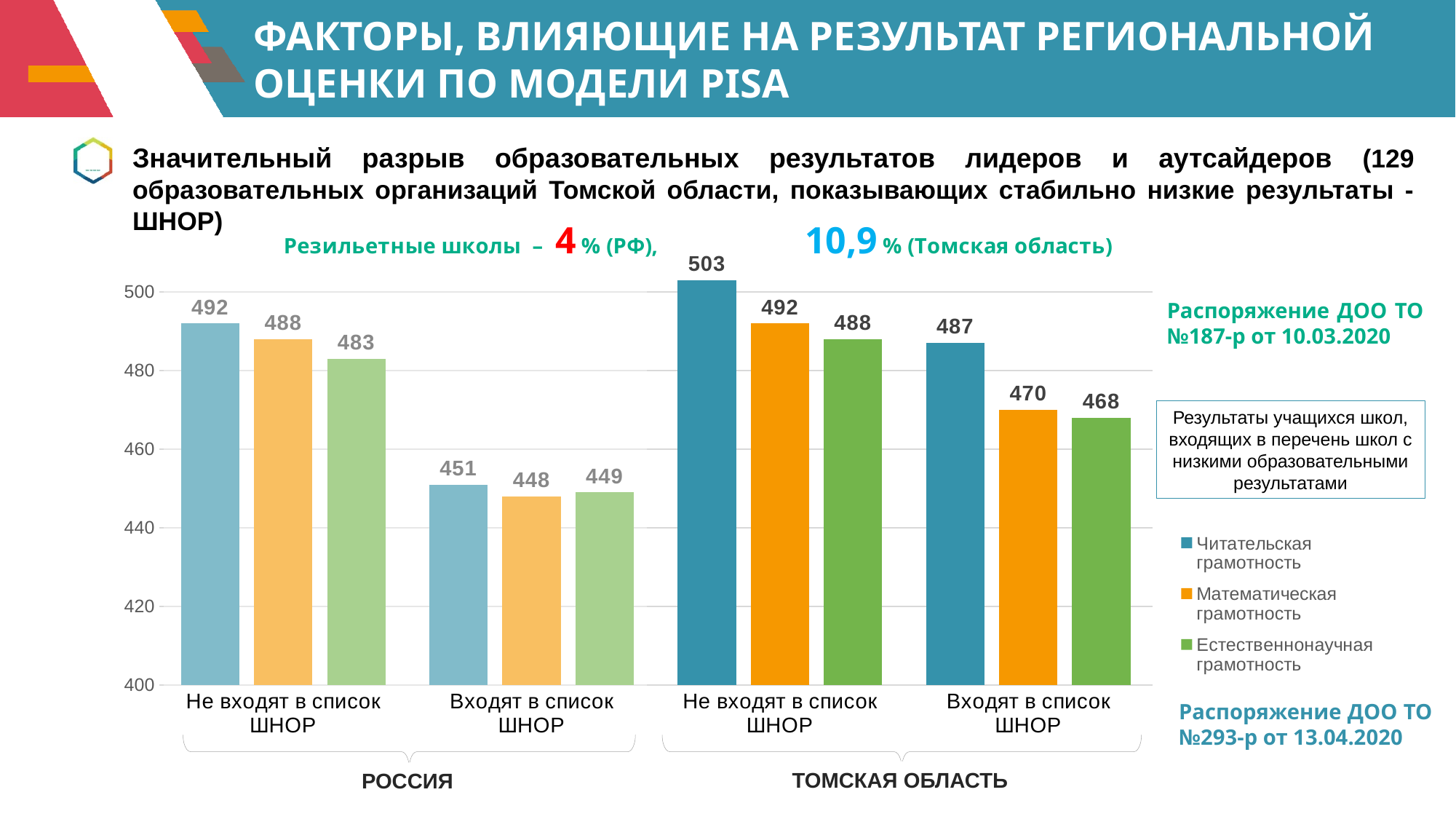
Which colour represents Математическая грамотность in the legend? Orange How many category groups are shown on the x axis? 4 What is the value of Естественнонаучная грамотность for schools in Томская область that are in the ШНОР list (Входят в список ШНОР)? 468 Which is larger: Читательская грамотность for Томская область schools in the ШНОР list, or Читательская грамотность for Россия schools not in the ШНОР list? Россия, Не входят в список ШНОР (492) What kind of chart is shown on the slide? Bar chart Which bar has the highest value on the chart? Читательская грамотность, Томская область, Не входят в список ШНОР (503) What is the difference between Математическая грамотность for Томская область schools not in the ШНОР list and those in the ШНОР list? 22 What is the value of Математическая грамотность for schools in Россия that are in the ШНОР list (Входят в список ШНОР)? 448 Which bar has the lowest value on the chart? Математическая грамотность, Россия, Входят в список ШНОР (448) How many series does the legend list? 3 What is the difference between Читательская грамотность for Россия schools not in the ШНОР list and Россия schools in the ШНОР list? 41 What is the value of Читательская грамотность for schools in Томская область that are not in the ШНОР list (Не входят в список ШНОР)? 503